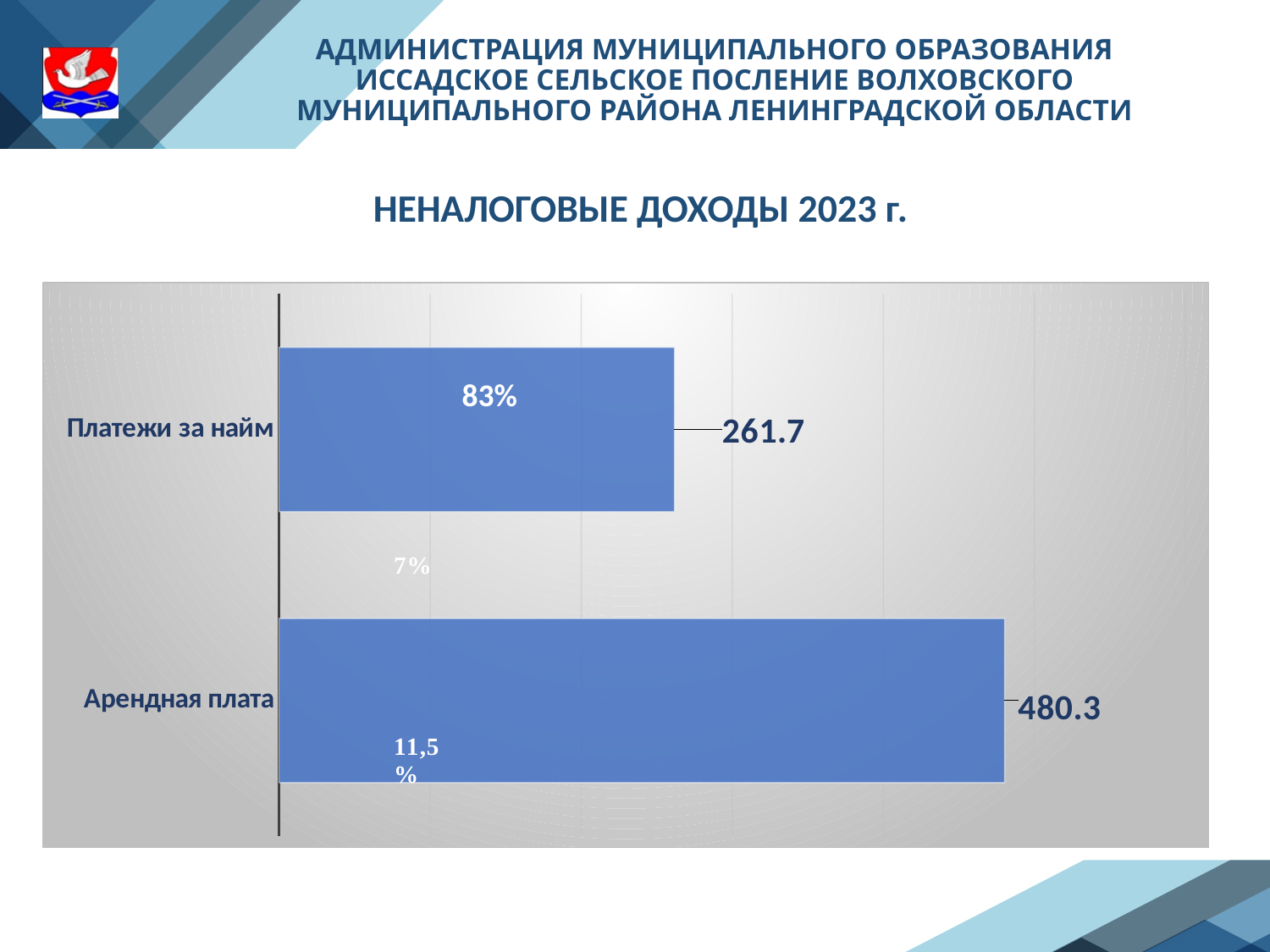
What is the title of the chart? НЕНАЛОГОВЫЕ ДОХОДЫ 2023 г. Which category has the lowest value? Платежи за найм What is the value for Арендная плата? 480.3 Which category has the highest value? Арендная плата What is the value for Платежи за найм? 261.7 Which is larger, the value for Платежи за найм or the value for Арендная плата? Арендная плата How many categories are shown in the chart? 2 What is the difference between the values for Арендная плата and Платежи за найм? 218.6 What colour are the bars in the chart? Blue What is the total of the two values shown in the chart? 742 What kind of chart is shown on the slide? Bar chart